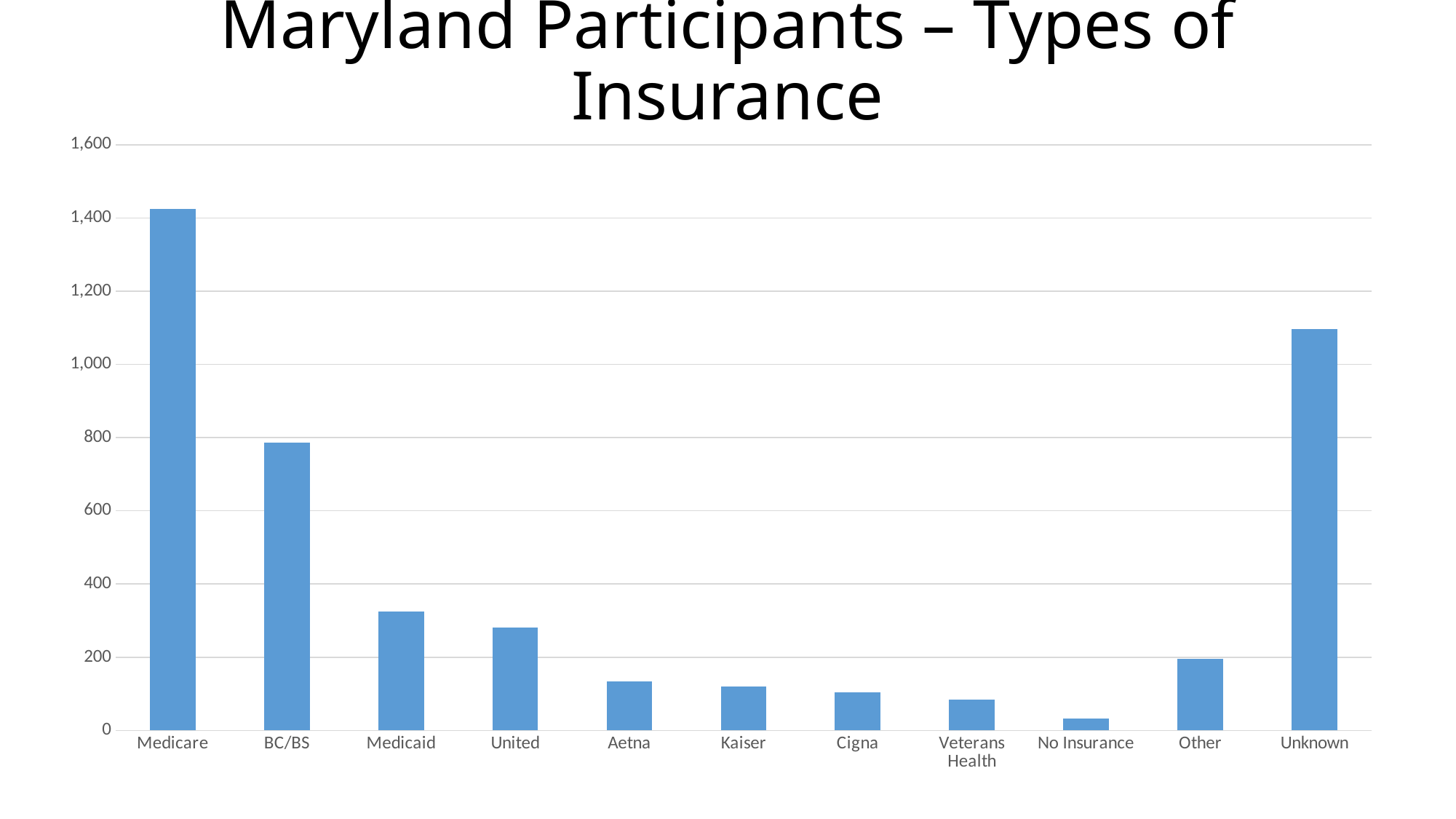
Is the value for Medicare greater or less than 1,400? greater Which is larger, the value for Unknown or the value for BC/BS? Unknown Is the value for Medicaid greater or less than 400? less What type of chart is shown on the slide? bar chart Is the value for No Insurance greater or less than 200? less How many insurance categories are shown on the x axis? 11 Which is larger, the value for Medicaid or the value for United? Medicaid What is the title of the chart? Maryland Participants – Types of Insurance Which category has the highest value? Medicare Which category has the lowest value? No Insurance